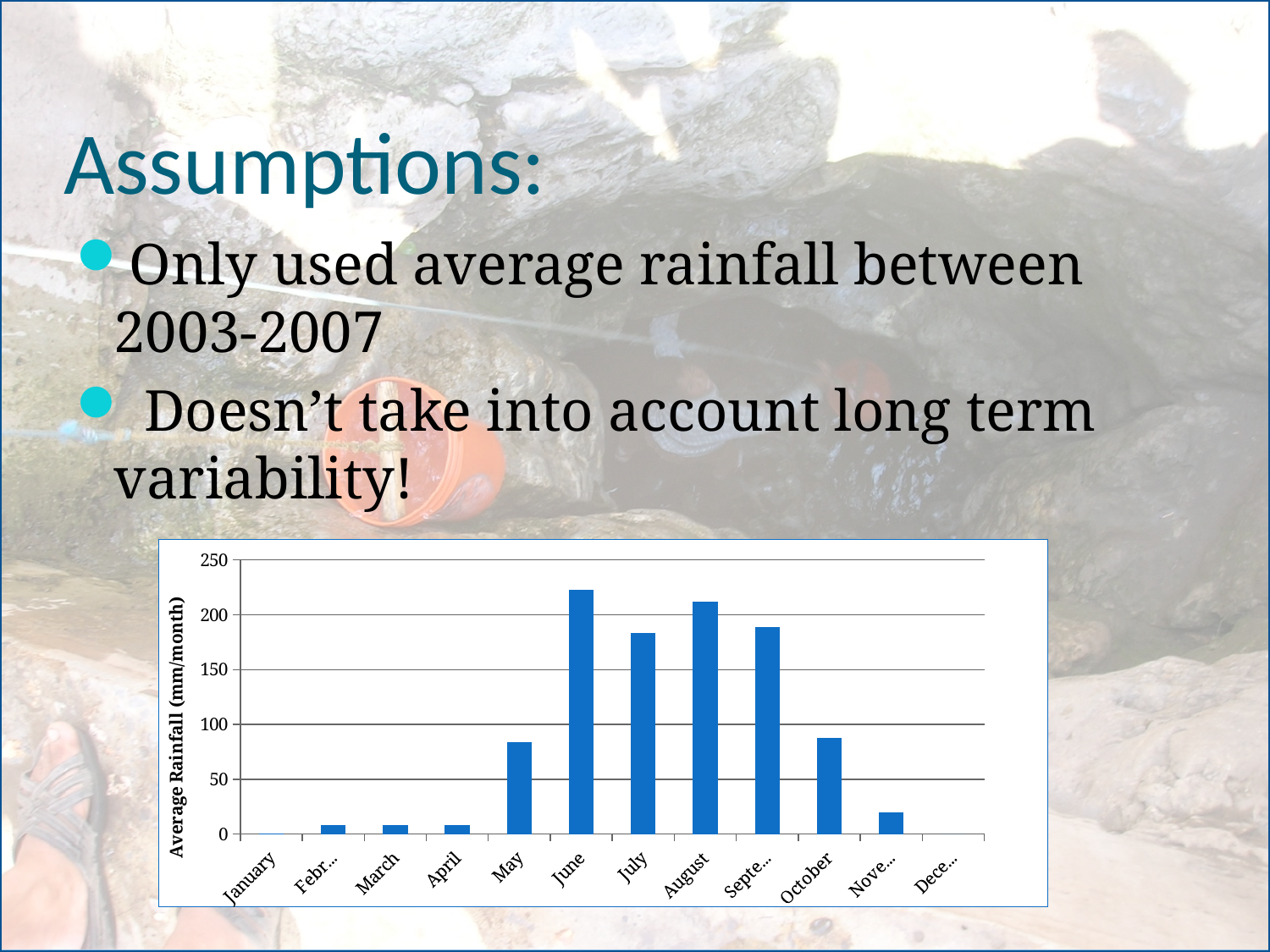
Is the average rainfall for October greater or less than 50? greater Which month has the highest average rainfall in the chart? June Which month has higher average rainfall, August or October? August How many months are shown on the x axis of the chart? 12 Is the average rainfall for June greater or less than 200? greater Does the average rainfall rise or fall from April to June? rise Is the average rainfall for March greater or less than 50? less What is the label on the vertical axis of the chart? Average Rainfall (mm/month) Which month has higher average rainfall, June or July? June What kind of chart is shown on the slide? bar chart